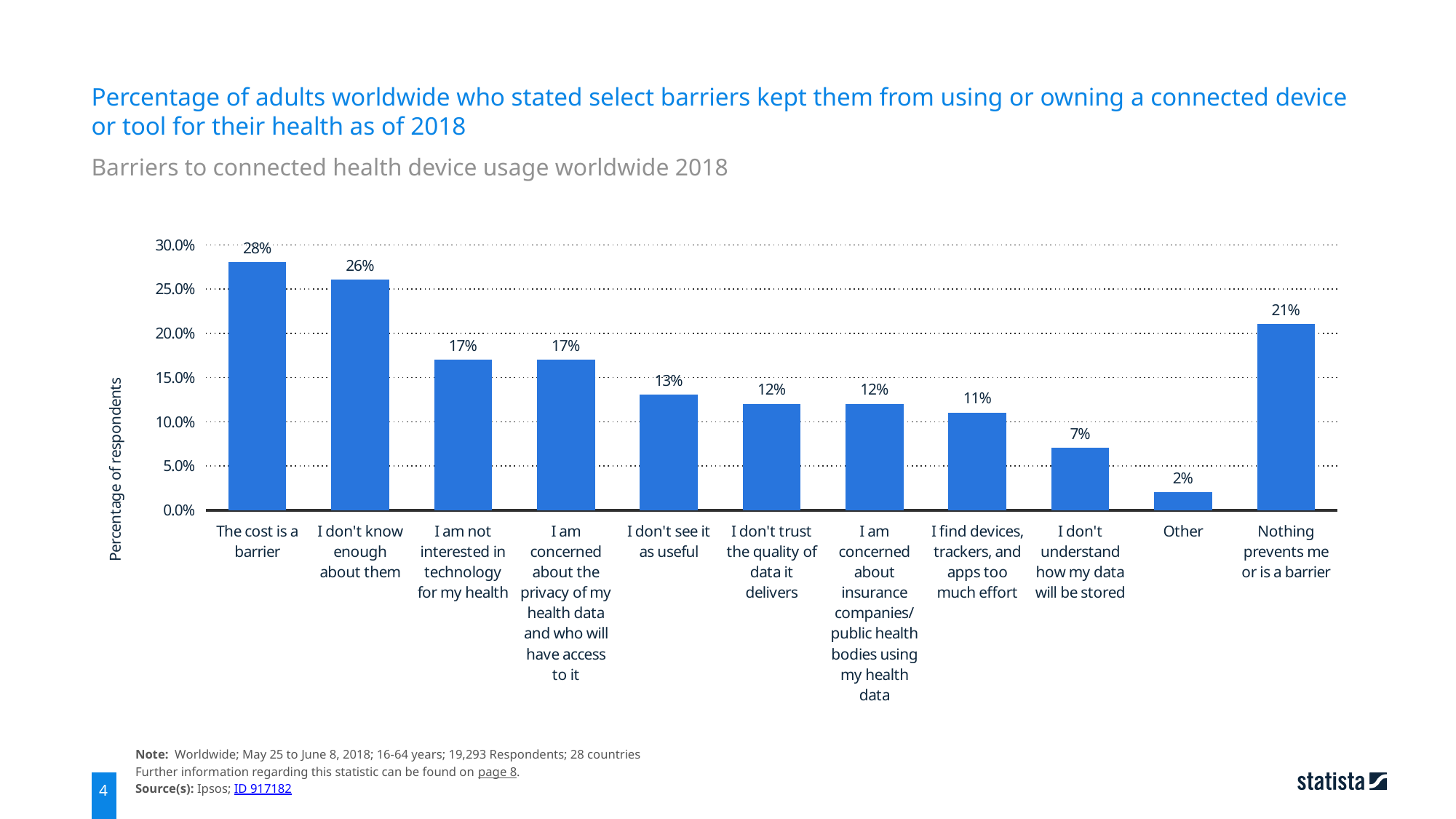
What percentage of respondents stated that cost is a barrier? 28% How many barrier categories are shown on the chart? 11 What is the subtitle of the chart? Barriers to connected health device usage worldwide 2018 Which category has the lowest percentage of respondents? Other What percentage of respondents said they don't understand how their data will be stored? 7% What percentage of respondents said nothing prevents them or is a barrier? 21% Which is larger: the percentage for 'I don't see it as useful' or for 'I find devices, trackers, and apps too much effort'? I don't see it as useful What is the label of the vertical axis? Percentage of respondents What type of chart is shown on the slide? Bar chart Which barrier has the highest percentage of respondents? The cost is a barrier What is the difference in percentage points between 'The cost is a barrier' and 'I don't know enough about them'? 2 percentage points What is the difference in percentage points between 'Nothing prevents me or is a barrier' and 'Other'? 19 percentage points